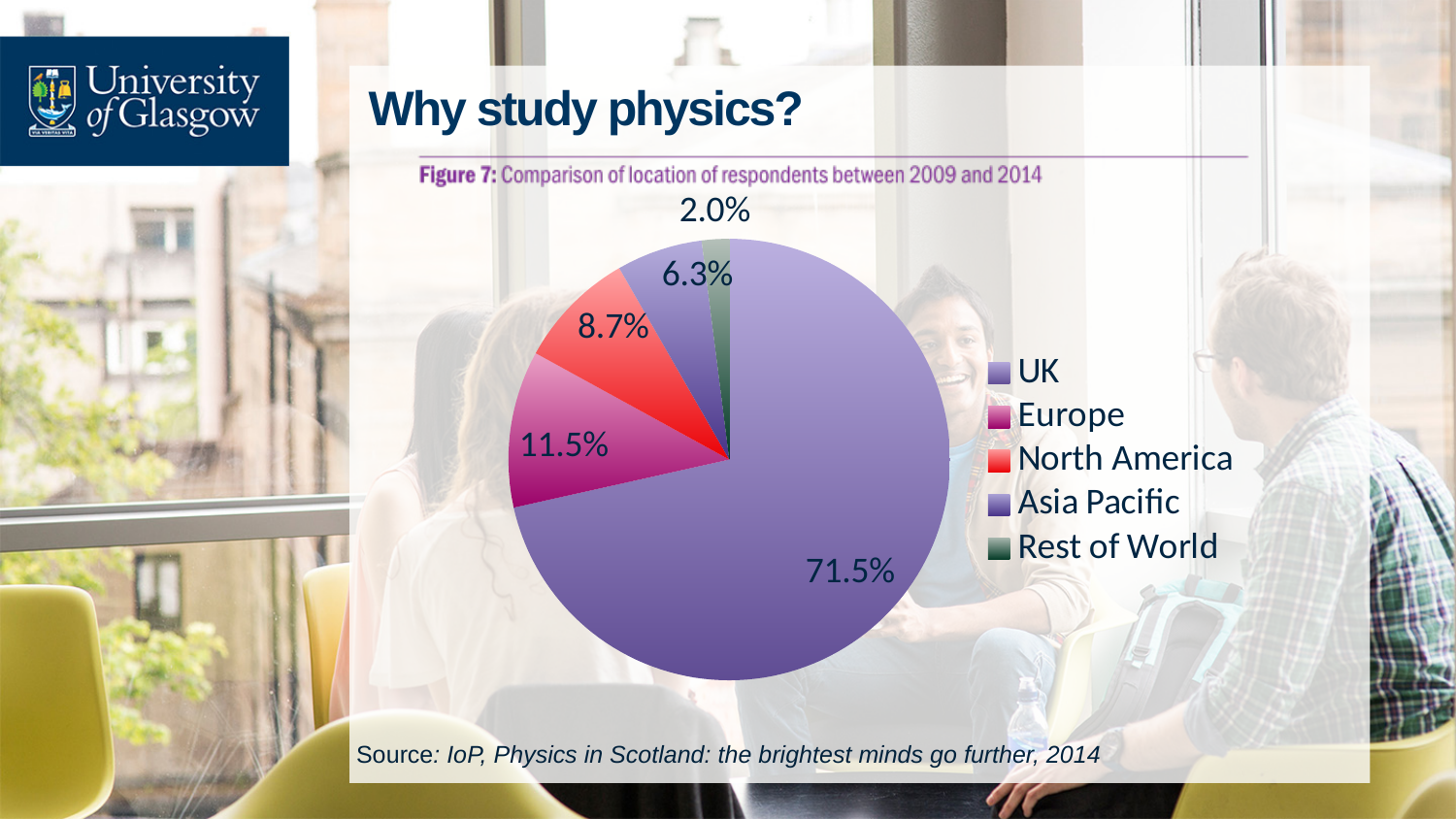
What share of respondents are from the UK? 71.5% How many locations does the legend list? 5 What share of respondents are from North America? 8.7% What share of respondents are from Asia Pacific? 6.3% What kind of chart is shown on the slide? pie chart Which has a larger share of respondents, Asia Pacific or North America? North America Which location has the largest share of respondents? UK What is the difference in percentage points between the Europe and North America shares? 2.8 Which location has the smallest share of respondents? Rest of World What is the figure caption of the chart? Figure 7: Comparison of location of respondents between 2009 and 2014 What share of respondents are from the Rest of World? 2.0% What share of respondents are from Europe? 11.5%